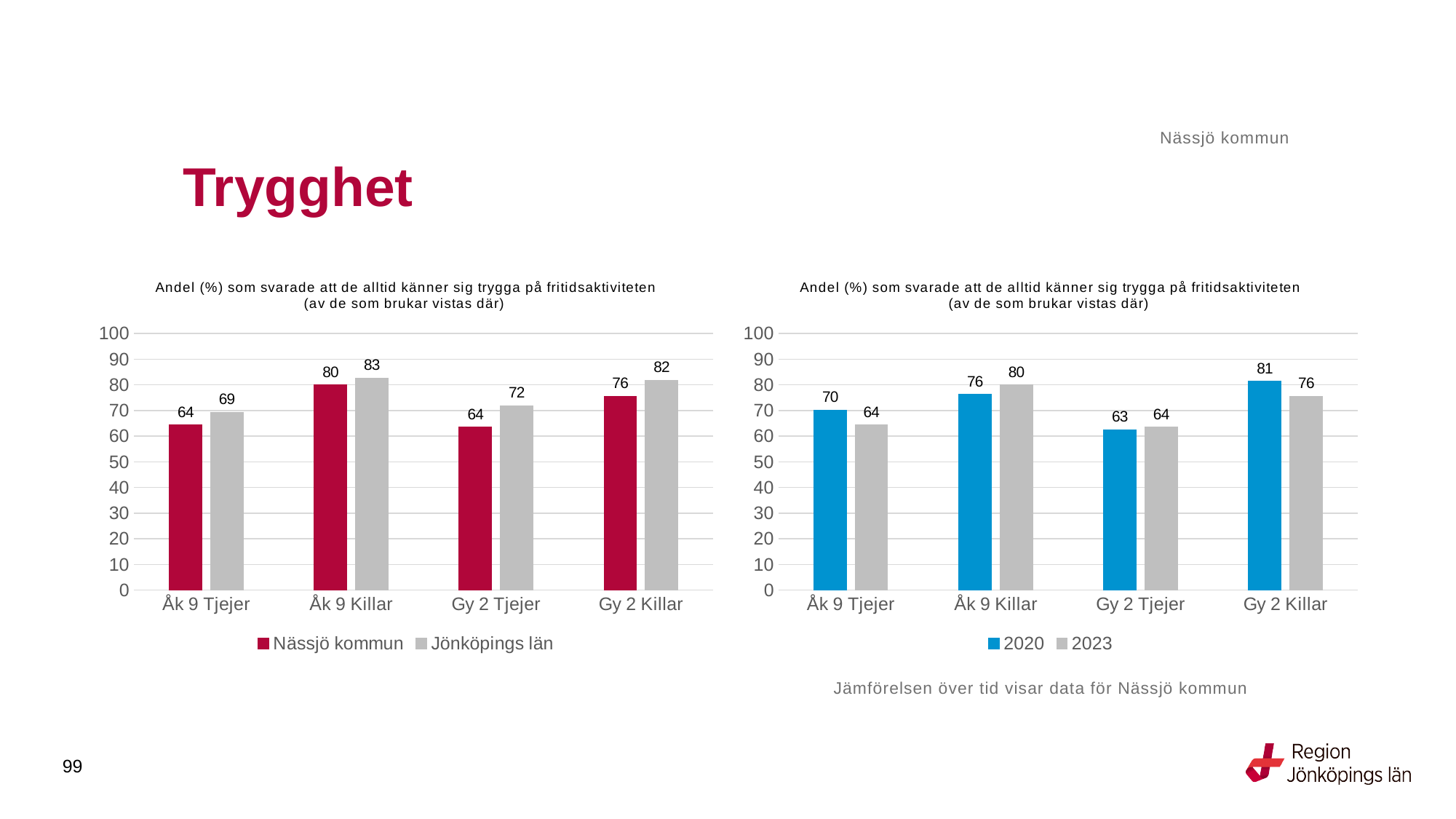
How many series does the legend of the right chart list? 2 In the right chart, what is the 2023 value for Åk 9 Tjejer? 64 In the left chart, what is the value for Jönköpings län for Gy 2 Tjejer? 72 How many categories are shown on the x axis of the left chart? 4 In the right chart, which is larger for Gy 2 Killar: the 2020 value or the 2023 value? 2020 In the right chart, which category has the lowest 2020 value? Gy 2 Tjejer In the left chart, what is the value for Nässjö kommun for Åk 9 Killar? 80 What type of chart is the left chart? Bar chart In the right chart, what is the 2020 value for Gy 2 Killar? 81 In the left chart, which category has the highest value for Jönköpings län? Åk 9 Killar In the left chart, what is the difference between Jönköpings län and Nässjö kommun for Gy 2 Tjejer? 8 In the right chart, what is the difference between the 2020 and 2023 values for Åk 9 Tjejer? 6